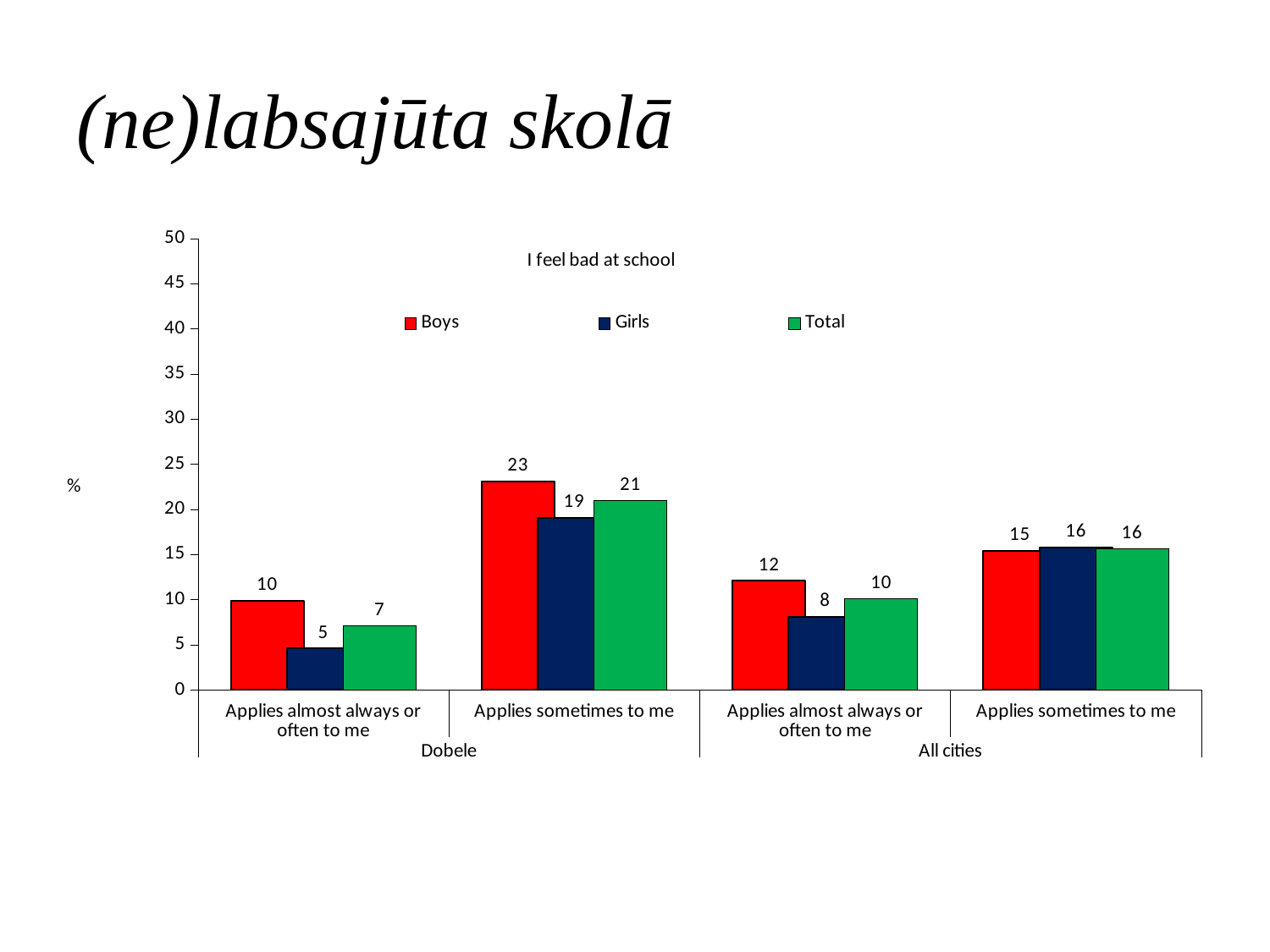
What kind of chart is shown on the slide? Bar chart Which series has the lowest value in the 'Applies almost always or often to me' category for All cities? Girls How many series does the legend list? 3 What is the title of the chart? I feel bad at school What is the value for Girls in the 'Applies almost always or often to me' category for Dobele? 5 Which series has the highest value in the 'Applies sometimes to me' category for Dobele? Boys What is the difference between the Boys and Girls values in the 'Applies sometimes to me' category for Dobele? 4 What colour represents the Girls series? Dark blue What is the Total value in the 'Applies sometimes to me' category for All cities? 16 What is the value for Boys in the 'Applies sometimes to me' category for Dobele? 23 What is the value for Boys in the 'Applies almost always or often to me' category for All cities? 12 Which is larger: the Boys value for 'Applies almost always or often to me' in Dobele or in All cities? All cities